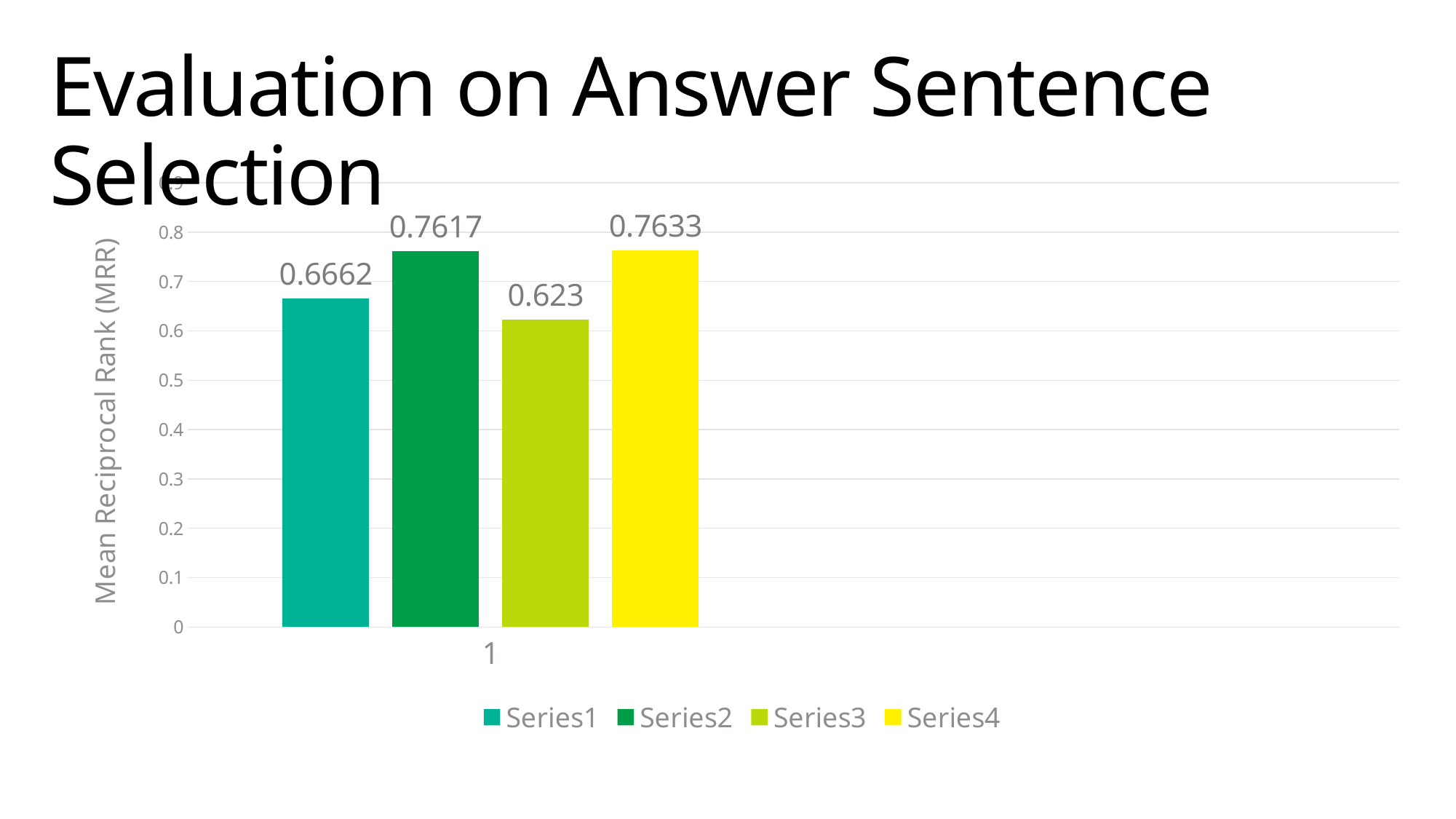
What is the difference between the values for Series4 and Series3? 0.1403 What kind of chart is shown on the slide? bar chart Is the value for Series1 greater or less than 0.7? less Which series has the highest value? Series4 What is the label on the vertical axis of the chart? Mean Reciprocal Rank (MRR) What is the value for Series1? 0.6662 How many series does the legend list? 4 What is the difference between the values for Series2 and Series1? 0.0955 Which series has the lowest value? Series3 What is the value for Series3? 0.623 What is the value for Series4? 0.7633 Which is larger, the value for Series1 or the value for Series3? Series1